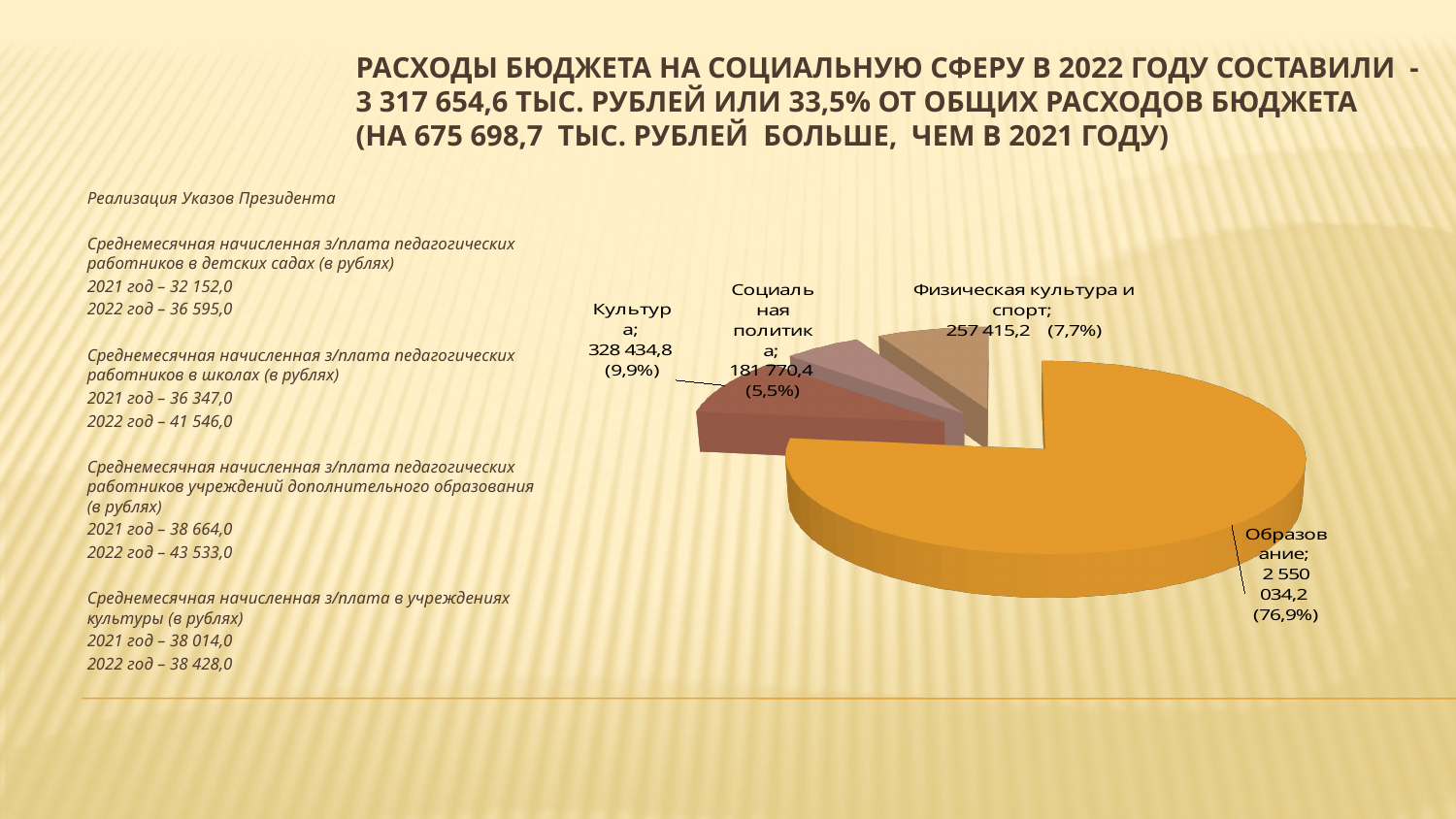
What is the difference between the values for Культура and Физическая культура и спорт? 71 019,6 What is the value shown for Образование in the pie chart? 2 550 034,2 How many slices does the pie chart have? 4 Which is larger, the value for Культура or the value for Социальная политика? Культура What is the value shown for Социальная политика in the pie chart? 181 770,4 Which category has the smallest slice in the pie chart? Социальная политика What share of the pie does Физическая культура и спорт account for? 7,7% What is the value shown for Физическая культура и спорт in the pie chart? 257 415,2 What kind of chart is shown on the slide? pie chart Which category has the largest slice in the pie chart? Образование What is the value shown for Культура in the pie chart? 328 434,8 What share of the pie does Образование account for? 76,9%